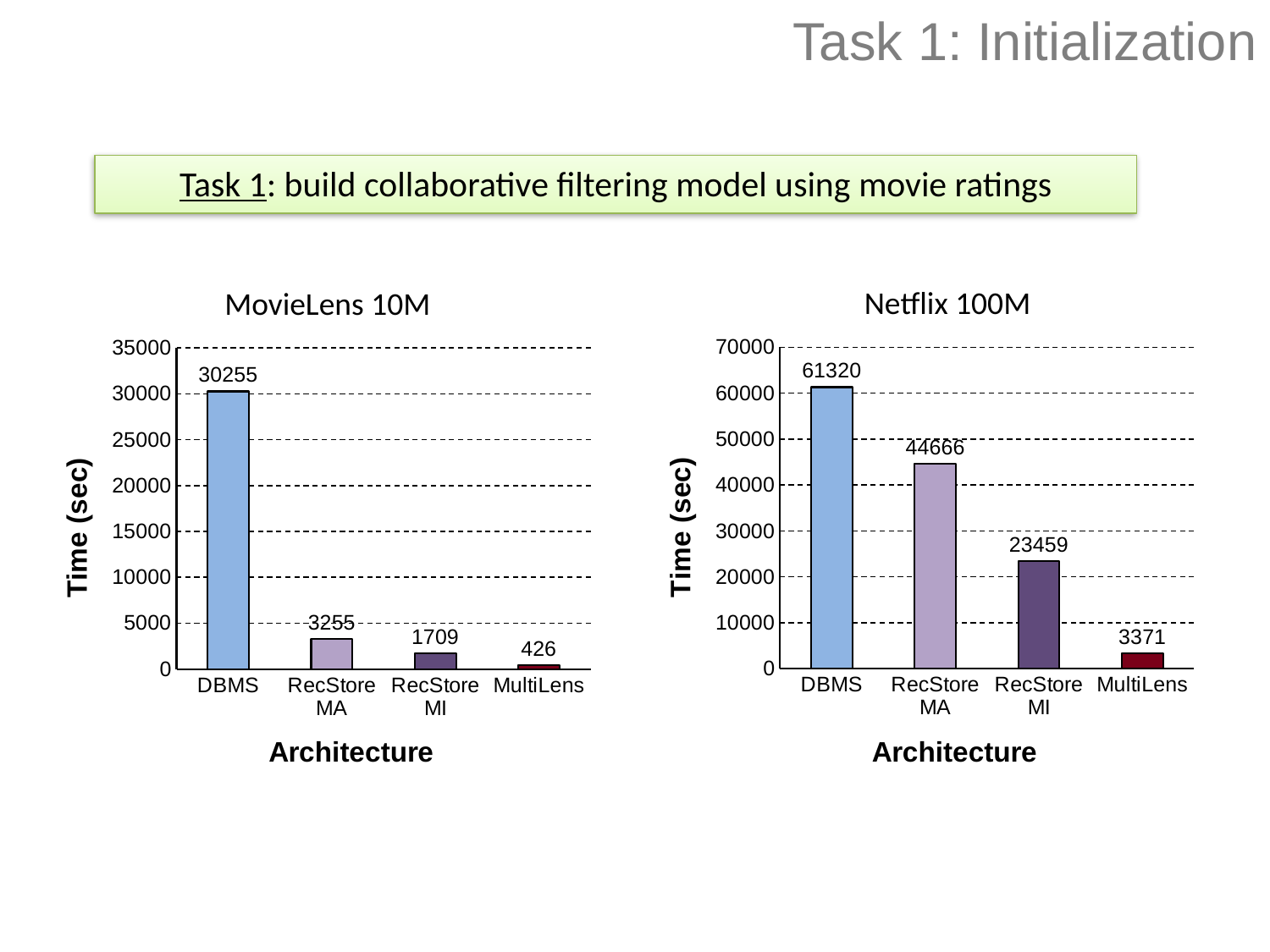
In the Netflix 100M chart, which architecture has the highest time? DBMS In the MovieLens 10M chart, what is the time in seconds for DBMS? 30255 In the Netflix 100M chart, which has a larger time, RecStore MI or MultiLens? RecStore MI In the MovieLens 10M chart, which architecture has the lowest time? MultiLens What is the y-axis label of the MovieLens 10M chart? Time (sec) How many architectures are shown in the Netflix 100M chart? 4 In the MovieLens 10M chart, is the value for RecStore MA greater or less than 5000? less In the Netflix 100M chart, what is the time in seconds for RecStore MI? 23459 In the MovieLens 10M chart, what is the difference in time between RecStore MA and RecStore MI? 1546 In the Netflix 100M chart, what is the difference in time between DBMS and RecStore MA? 16654 In the Netflix 100M chart, do the values rise or fall from DBMS to MultiLens along the x axis? fall What kind of chart is the MovieLens 10M chart? bar chart